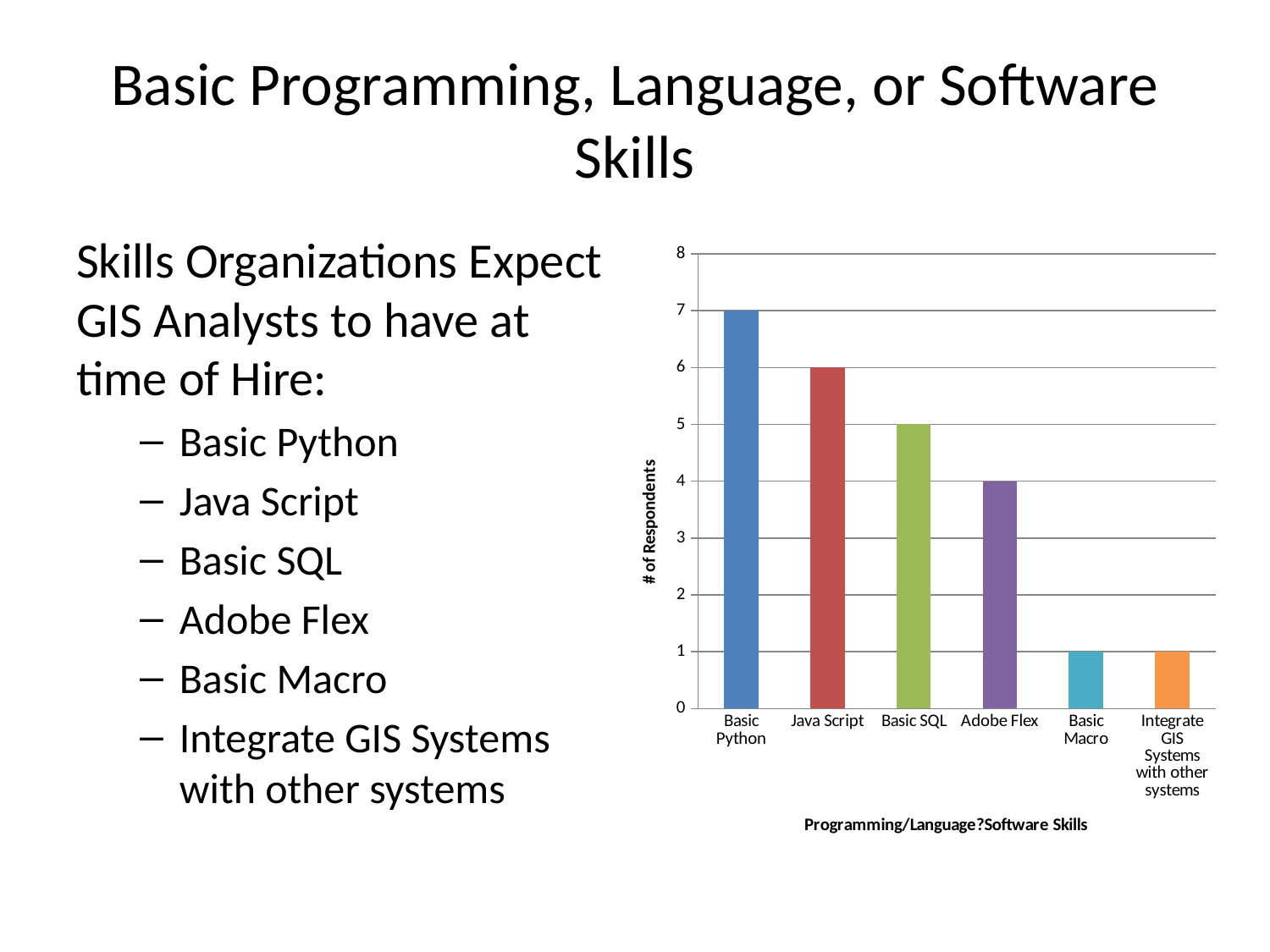
What is the number of respondents for Basic Python? 7 What is the number of respondents for Java Script? 6 What is the number of respondents for Adobe Flex? 4 What type of chart is shown on the slide? bar chart What is the number of respondents for Basic SQL? 5 Which category has the highest number of respondents? Basic Python What is the title of the vertical axis? # of Respondents Do the values rise or fall moving from left to right along the x axis? fall How many categories are plotted on the chart? 6 Which has more respondents, Java Script or Basic SQL? Java Script What is the number of respondents for Basic Macro? 1 What is the difference in respondents between Basic Python and Adobe Flex? 3